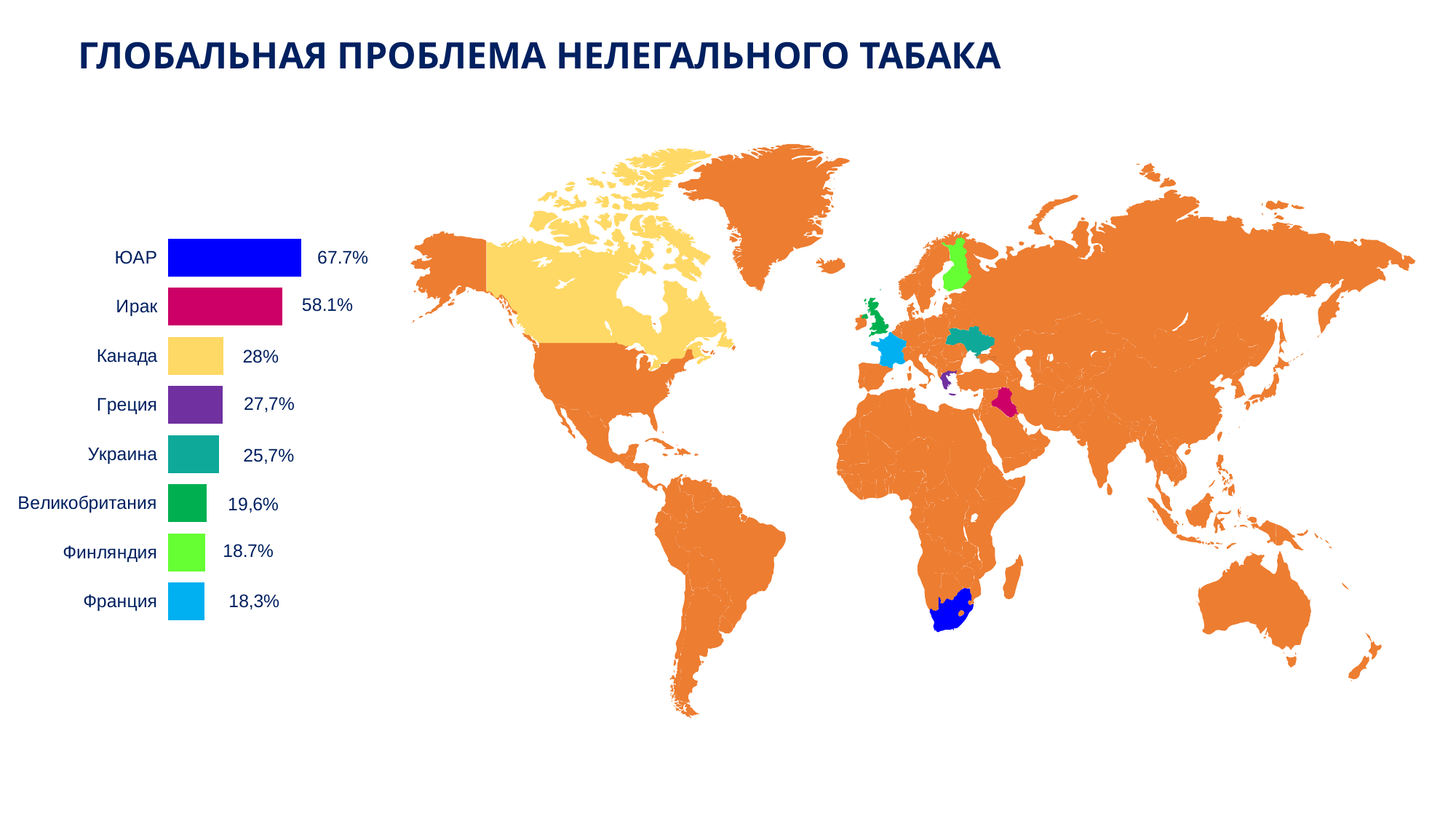
What is the value shown for Канада in the bar chart? 28% What is the value shown for Франция in the bar chart? 18,3% Which country has the lowest value in the bar chart? Франция What is the difference between the values for ЮАР and Ирак? 9.6 percentage points Which country has the highest value in the bar chart? ЮАР What is the value shown for ЮАР in the bar chart? 67.7% What is the value shown for Украина in the bar chart? 25,7% What is the value shown for Ирак in the bar chart? 58.1% What is the title of the slide? ГЛОБАЛЬНАЯ ПРОБЛЕМА НЕЛЕГАЛЬНОГО ТАБАКА What kind of chart is shown on the left of the slide? Bar chart Which has a larger value, Великобритания or Финляндия? Великобритания How many countries are listed in the bar chart? 8